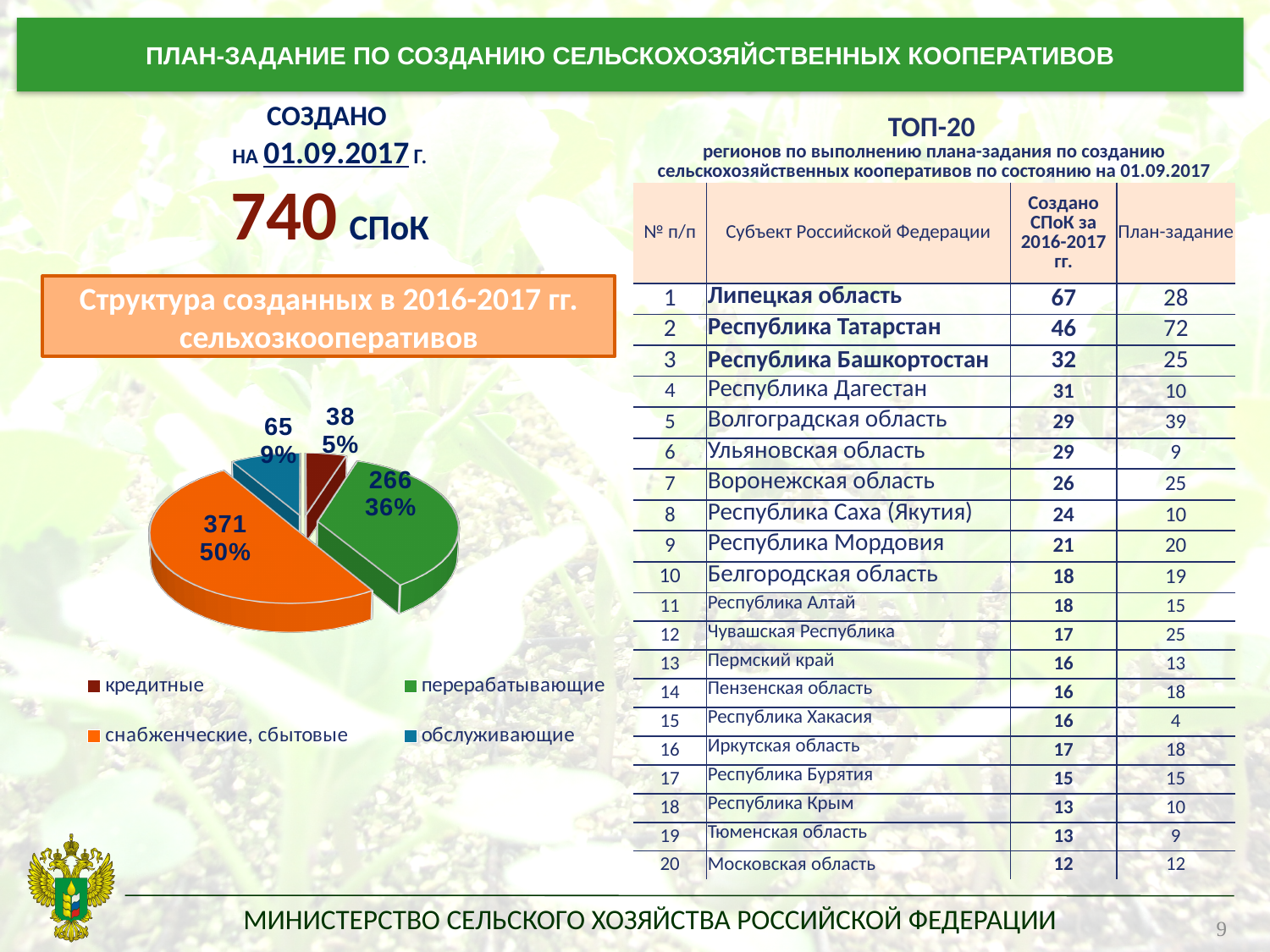
Which category has the largest slice in the pie chart? снабженческие, сбытовые What is the value for обслуживающие in the pie chart? 65 What is the value for кредитные in the pie chart? 38 What share of the pie does кредитные take? 5% Which category has the smallest slice in the pie chart? кредитные How many entries does the pie chart legend list? 4 What share of the pie does снабженческие, сбытовые take? 50% What is the value for перерабатывающие in the pie chart? 266 How many slices does the pie chart have? 4 What is the value for снабженческие, сбытовые in the pie chart? 371 What kind of chart is shown on the slide? pie chart What is the difference between the values for снабженческие, сбытовые and перерабатывающие? 105